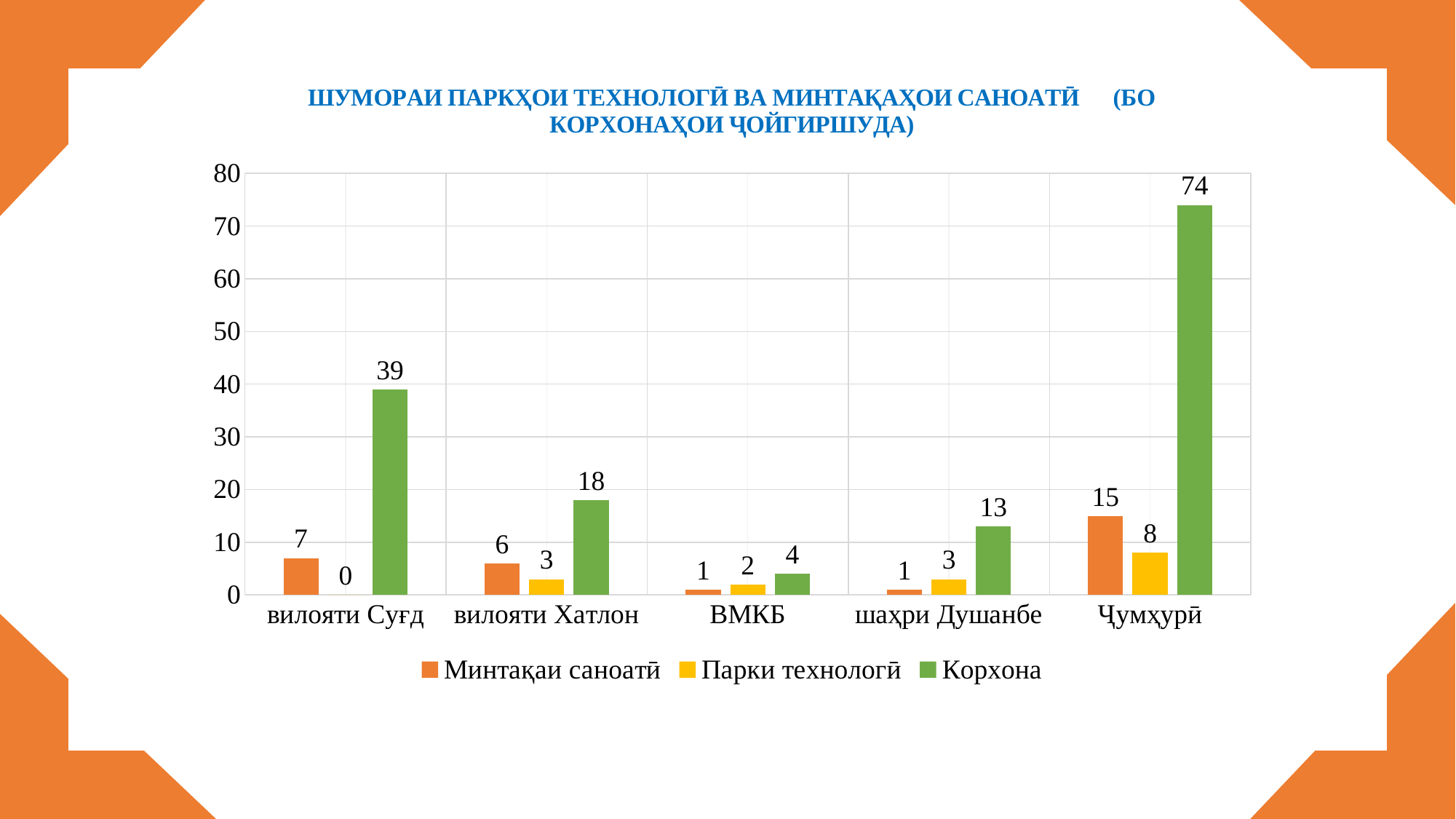
What is the value of Парки технологӣ for вилояти Суғд? 0 Is the Корхона value for Ҷумҳурӣ greater or less than 70? greater What kind of chart is shown on the slide? bar chart Which category has the lowest Корхона value? ВМКБ What is the value of Минтақаи саноатӣ for Ҷумҳурӣ? 15 What is the value of Корхона for вилояти Суғд? 39 Which is larger: Минтақаи саноатӣ for вилояти Суғд or Минтақаи саноатӣ for вилояти Хатлон? вилояти Суғд How many categories are shown on the x axis? 5 What is the value of Парки технологӣ for вилояти Хатлон? 3 Which category has the highest Корхона value? Ҷумҳурӣ How many series does the legend list? 3 What is the difference between the Корхона values for Ҷумҳурӣ and вилояти Суғд? 35